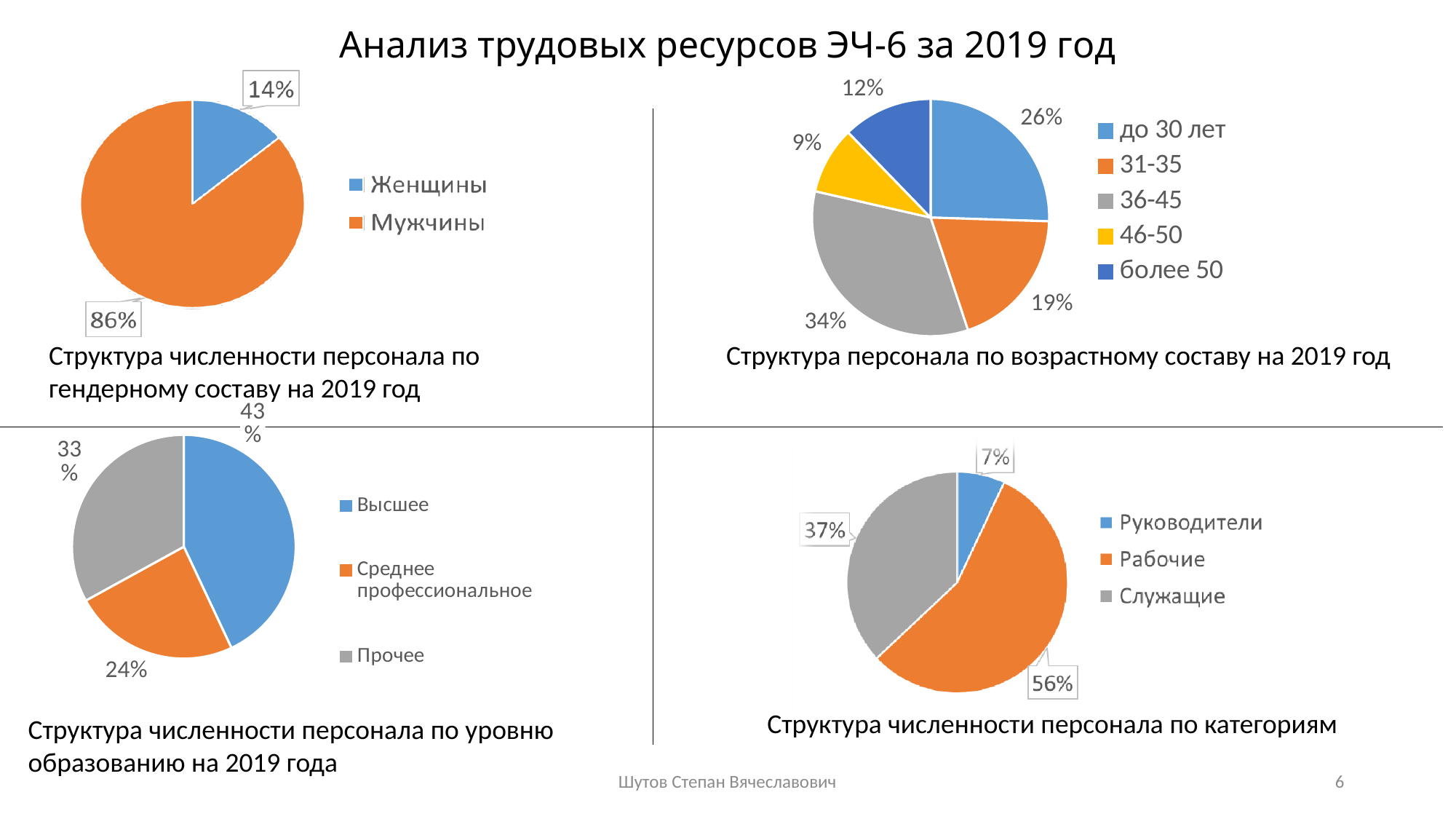
In the bottom-left chart (education level), which category has the largest share? Высшее In the top-right chart (age structure), what is the difference between the shares of '36-45' and '31-35'? 15% In the top-left chart (gender structure), what share of personnel are Мужчины? 86% In the top-right chart (age structure), how many age groups does the legend list? 5 In the top-right chart (age structure), which age group has the smallest share? 46-50 In the top-right chart (age structure), which age group has the largest share? 36-45 In the top-left chart (gender structure), what share of personnel are Женщины? 14% In the top-right chart (age structure), what is the share of the 'до 30 лет' group? 26% What type of chart is used for the bottom-right chart (personnel categories)? Pie chart In the bottom-right chart (personnel categories), which is larger: Руководители or Служащие? Служащие In the bottom-left chart (education level), what is the share of 'Среднее профессиональное'? 24% In the bottom-right chart (personnel categories), what is the share of Рабочие? 56%